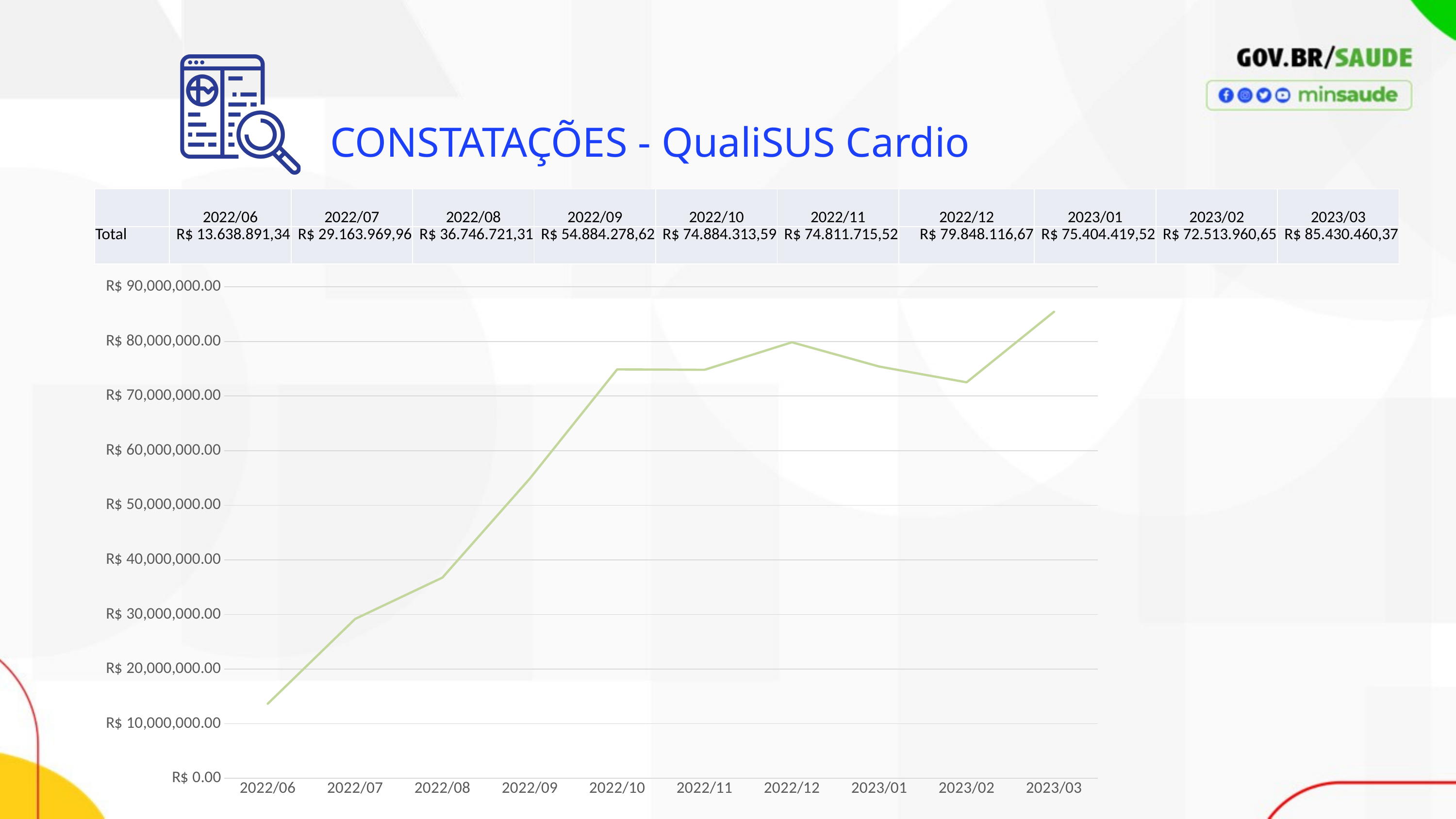
Which month has the lowest Total value? 2022/06 Which month has the highest Total value? 2023/03 What is the difference between the Total for 2022/07 and the Total for 2022/06? R$ 15.525.078,62 Which is larger, the Total for 2022/12 or the Total for 2023/01? 2022/12 Does the Total value generally rise or fall from 2022/06 to 2023/03? rise What is the Total value for 2022/12? R$ 79.848.116,67 What is the Total value for 2023/03? R$ 85.430.460,37 Is the value for 2022/09 greater or less than R$ 50,000,000.00? greater What is the difference between the Total for 2023/03 and the Total for 2023/02? R$ 12.916.499,72 What is the Total value for 2022/06? R$ 13.638.891,34 What kind of chart is shown on the slide? line chart How many months are plotted on the x axis of the chart? 10